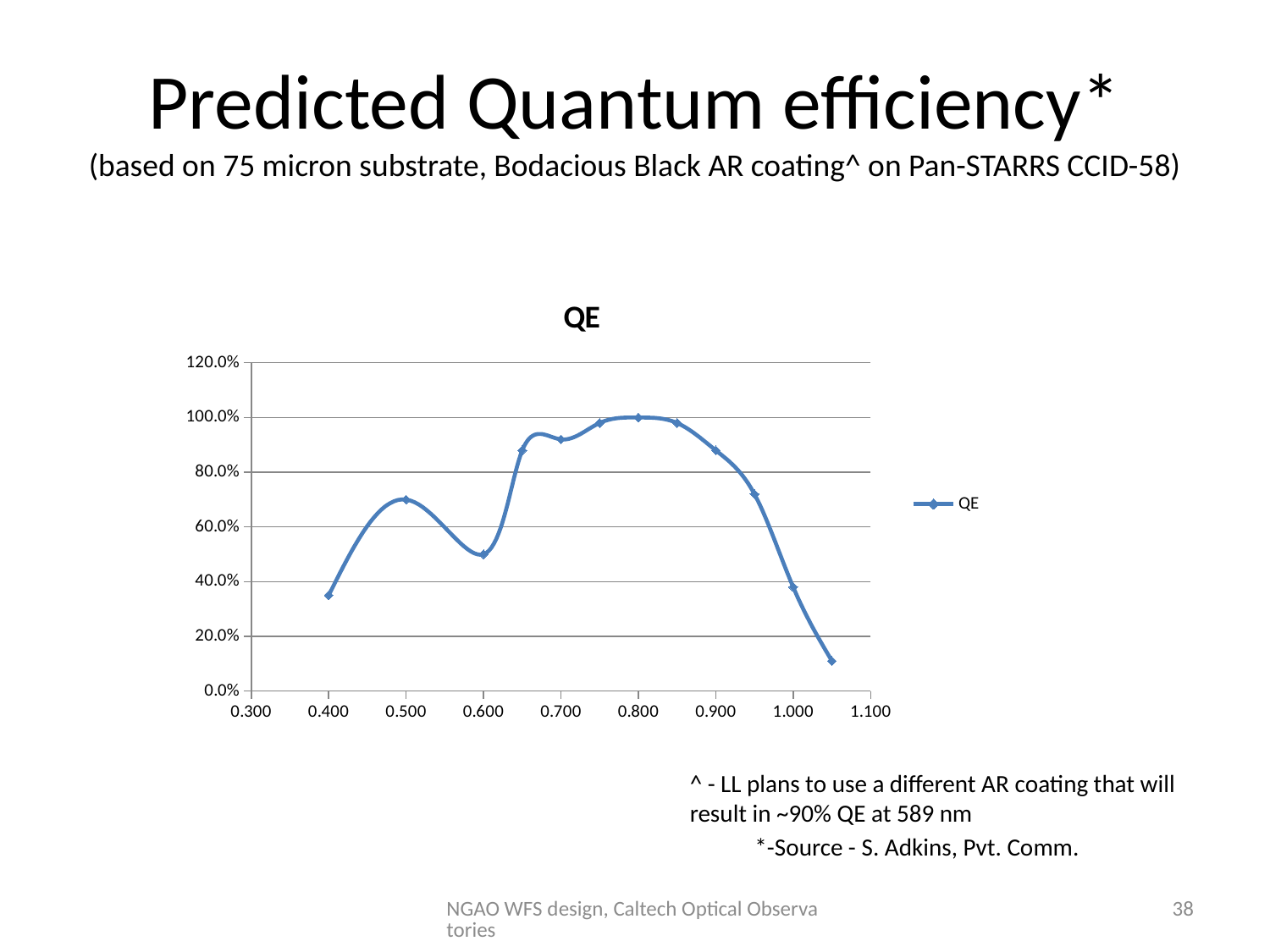
What is the QE value at x = 0.800? 100.0% At which x value does the QE line reach its highest point? 0.800 Do the QE values rise or fall along the x axis from 0.800 to 1.050? fall Which has the larger QE value, x = 0.500 or x = 0.600? 0.500 Is the QE value at x = 1.050 greater or less than 20.0%? less What is the title of the chart? QE Is the QE value at x = 0.500 greater or less than 60.0%? greater What kind of chart is shown on the slide? line chart How many series does the legend list? 1 How many data points are plotted on the QE line? 12 Is the QE value at x = 0.400 greater or less than 40.0%? less